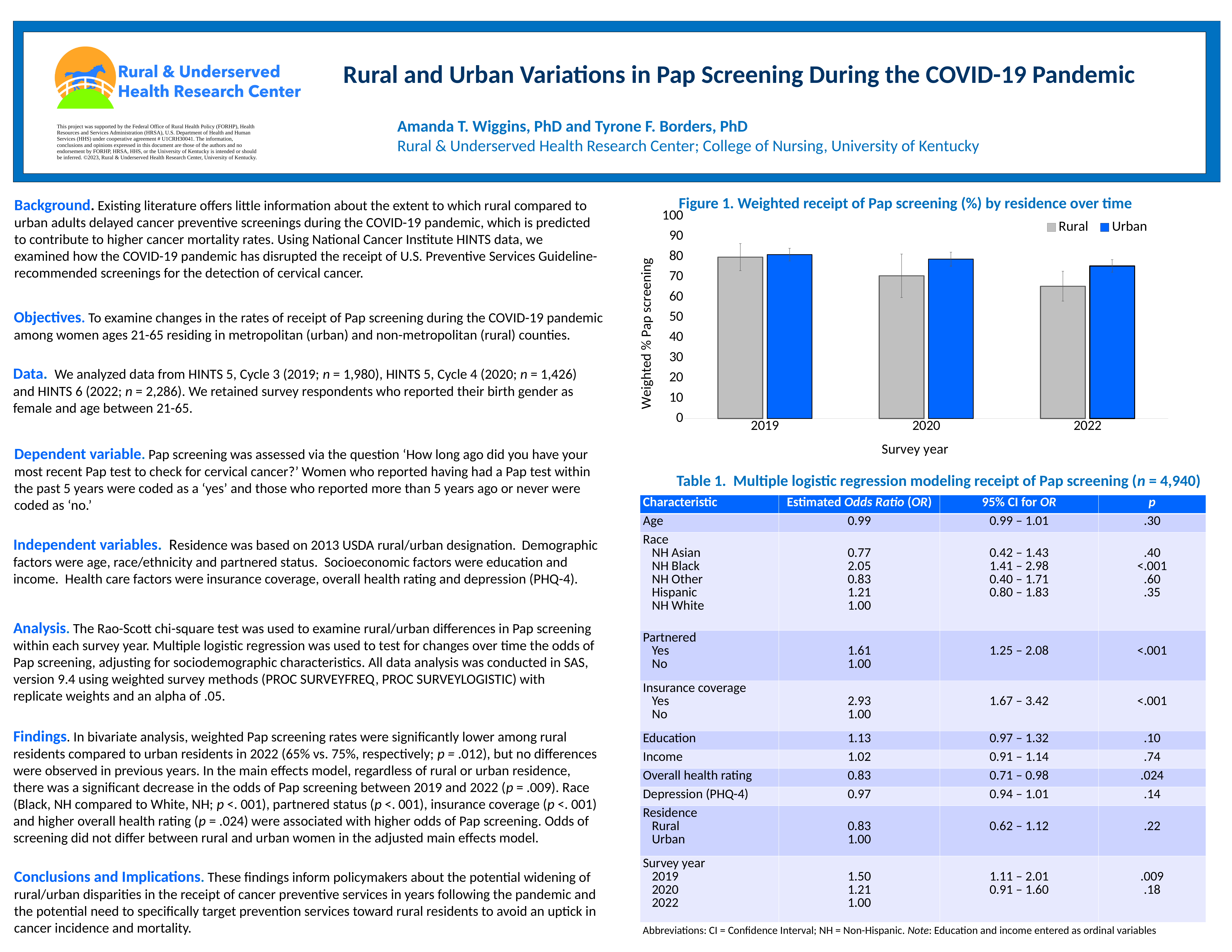
In Figure 1, which survey year has the lowest Urban value? 2022 In Figure 1, is the Rural value for 2022 greater or less than 70? less In Figure 1, which colour represents the Urban series? blue What kind of chart is Figure 1? bar chart In Figure 1, is the Rural value for 2020 greater or less than 60? greater How many survey years are shown on the x axis of Figure 1? 3 In Figure 1, for 2022, which is larger: the Rural value or the Urban value? Urban How many series does the legend of Figure 1 list? 2 In Figure 1, do the Rural values rise or fall from 2019 to 2022? fall In Figure 1, is the Urban value for 2022 greater or less than 70? greater In Figure 1, which survey year has the highest Rural value? 2019 In Figure 1, which survey year has the lowest Rural value? 2022